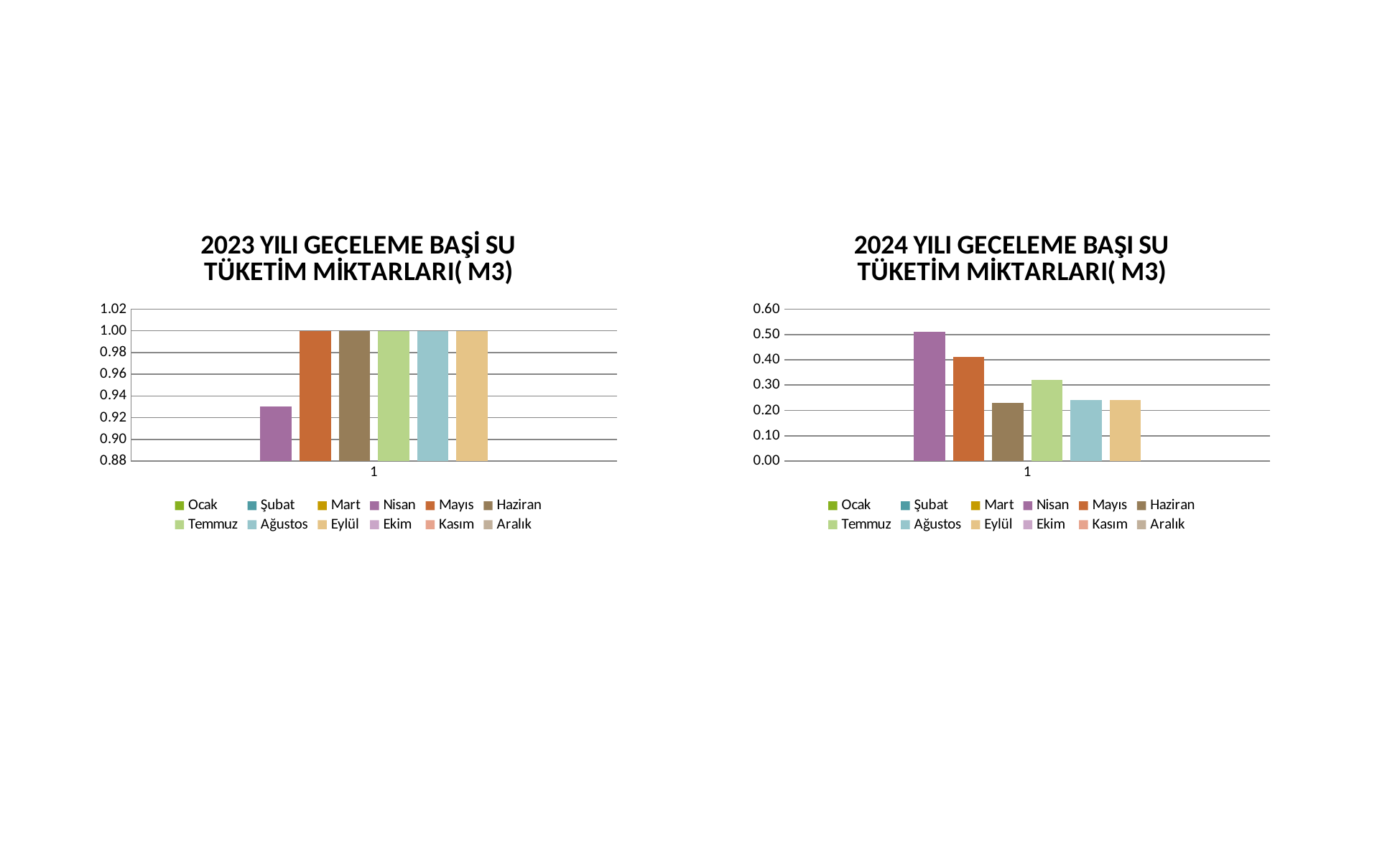
In the 2023 chart, is the value for Nisan greater or less than 0.94? less In the 2023 chart, what is the value for Mayıs? 1.00 In the 2024 chart, is the value for Ağustos greater or less than 0.30? less How many bars are plotted in the 2024 YILI GECELEME BAŞI SU TÜKETİM MİKTARLARI( M3) chart? 6 In the 2024 chart, is the value for Nisan greater or less than 0.40? greater How many series does the legend of the 2023 chart list? 12 In the 2024 chart, which is larger, the value for Mayıs or the value for Temmuz? Mayıs In the 2023 chart, which is larger, the value for Nisan or the value for Temmuz? Temmuz What type of chart is the 2023 YILI GECELEME BAŞİ SU TÜKETİM MİKTARLARI( M3) chart? bar chart In the 2024 chart, what colour is the bar for Nisan? purple In the 2024 chart, which month has the highest value? Nisan In the 2023 chart, what is the value for Eylül? 1.00